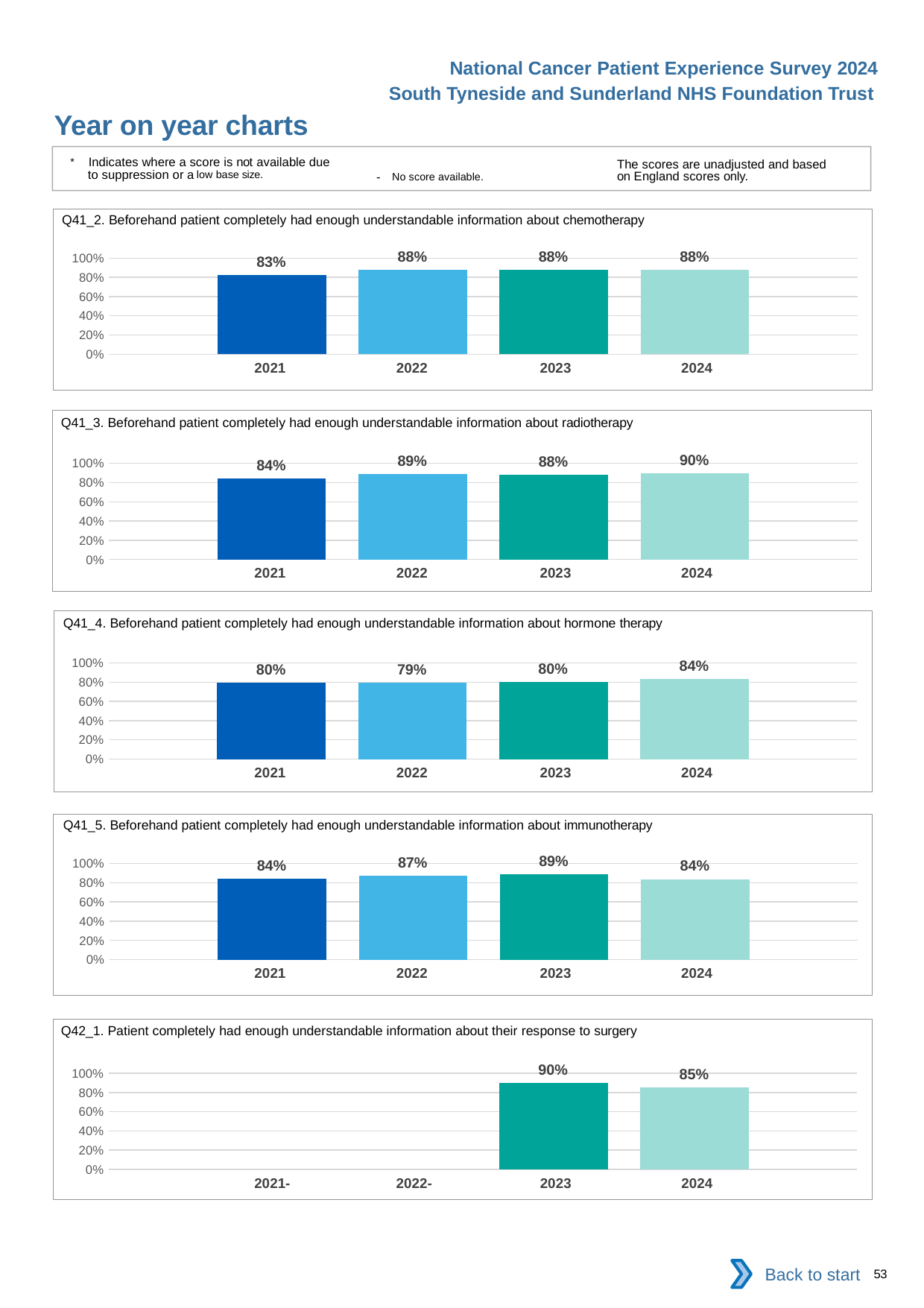
In the Q41_5 immunotherapy chart, which year has the highest value? 2023 In the Q41_5 immunotherapy chart, is the value for 2022 larger or smaller than the value for 2024? larger In the Q41_4 hormone therapy chart, which year has the lowest value? 2022 In the Q42_1 response to surgery chart, how many years have a bar plotted? 2 What kind of chart is the Q41_2 chemotherapy chart? bar chart In the Q41_2 chemotherapy chart, how many years are shown on the x axis? 4 In the Q41_3 radiotherapy chart, what is the value for 2022? 89% In the Q42_1 response to surgery chart, what is the value for 2023? 90% In the Q42_1 response to surgery chart, what is the difference between the 2023 and 2024 values? 5% In the Q41_4 hormone therapy chart, what is the difference between the 2024 and 2021 values? 4% In the Q41_2 chemotherapy chart, what is the value for 2021? 83% In the Q41_3 radiotherapy chart, which year has the highest value? 2024